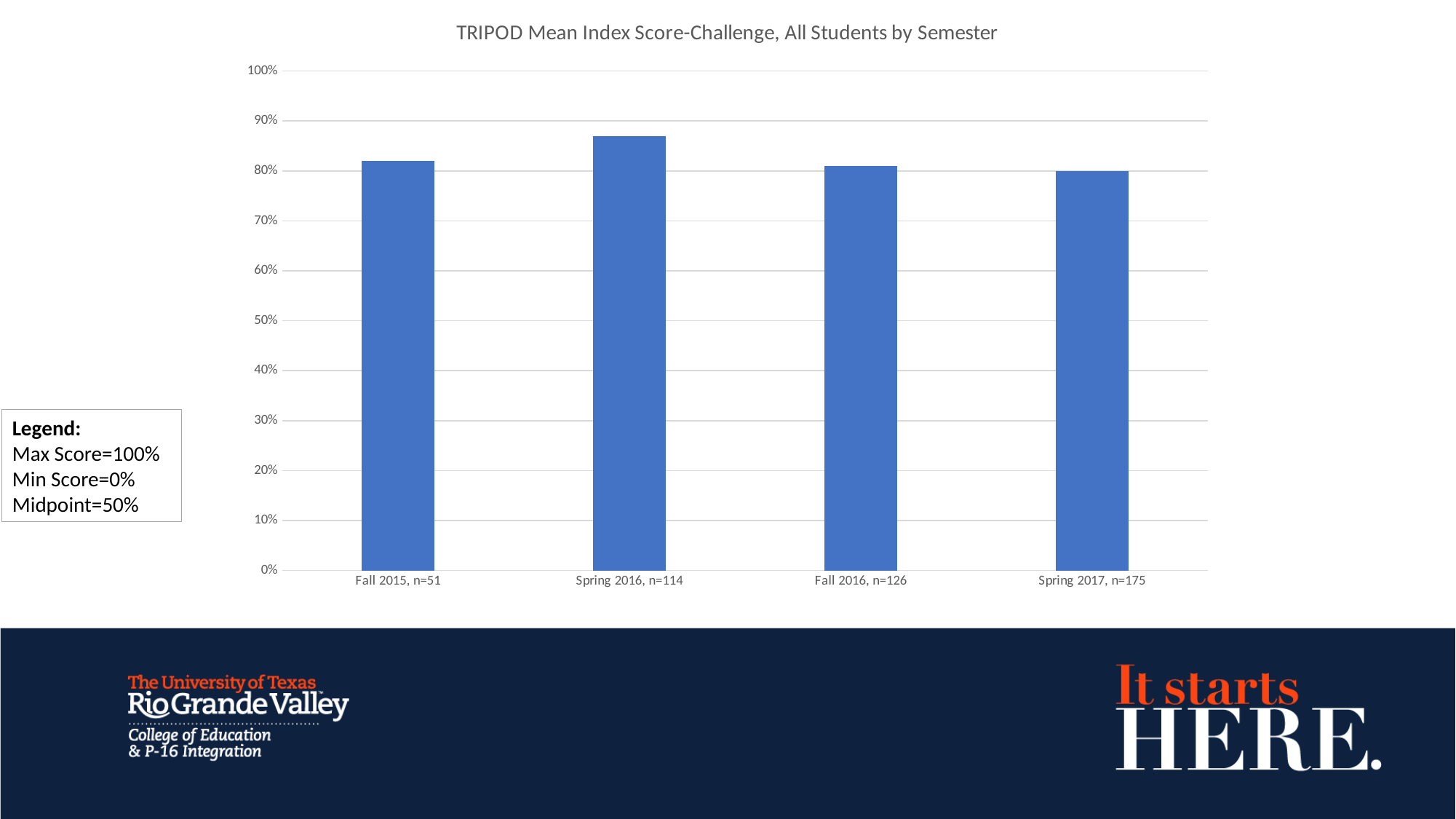
Is the value for Fall 2016 greater or less than 90%? less According to the legend box on the slide, what is the midpoint score? 50% How many semesters are plotted on the chart? 4 Which is larger, the value for Spring 2016 or the value for Fall 2015? Spring 2016 Which is larger, the value for Spring 2016 or the value for Spring 2017? Spring 2016 What is the title of the chart? TRIPOD Mean Index Score-Challenge, All Students by Semester What kind of chart is shown on the slide? bar chart Is the value for Fall 2015 greater or less than 80%? greater Is the value for Spring 2017 greater or less than 50%? greater Which semester has the highest mean index score? Spring 2016, n=114